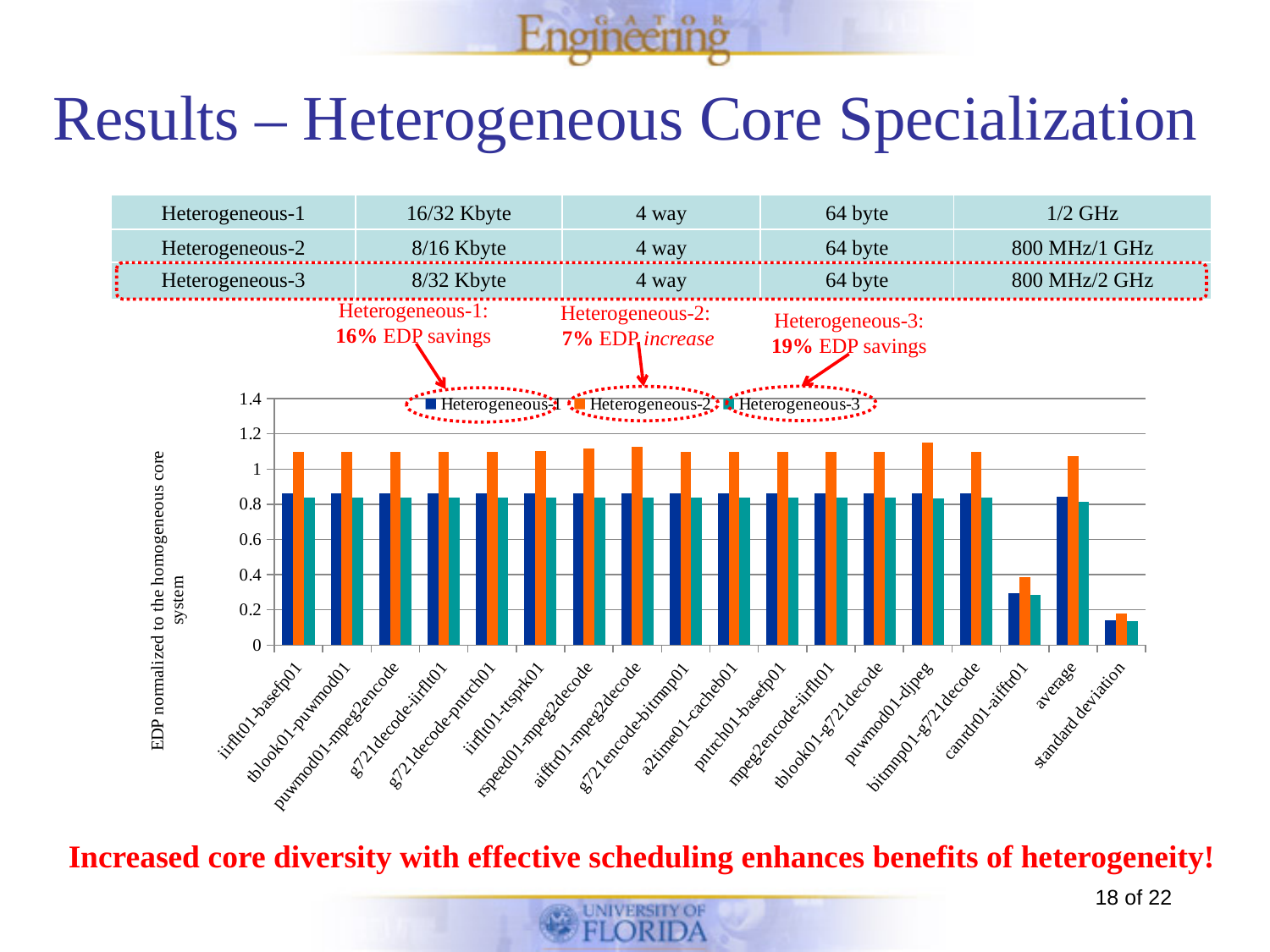
How many categories are shown along the x axis of the chart? 18 What is the title of the chart's y axis? EDP normalized to the homogeneous system Is the Heterogeneous-1 value for tblook01-puwmod01 greater or less than 1? less Is the Heterogeneous-1 value for standard deviation greater or less than 0.2? less Is the Heterogeneous-3 value for average greater or less than 0.6? greater Which series is shown in orange in the chart's legend? Heterogeneous-2 For iirflt01-basefp01, which is larger: the Heterogeneous-1 value or the Heterogeneous-2 value? Heterogeneous-2 How many series does the chart's legend list? 3 Which category has the lowest Heterogeneous-2 value? standard deviation What kind of chart is shown on the slide? bar chart